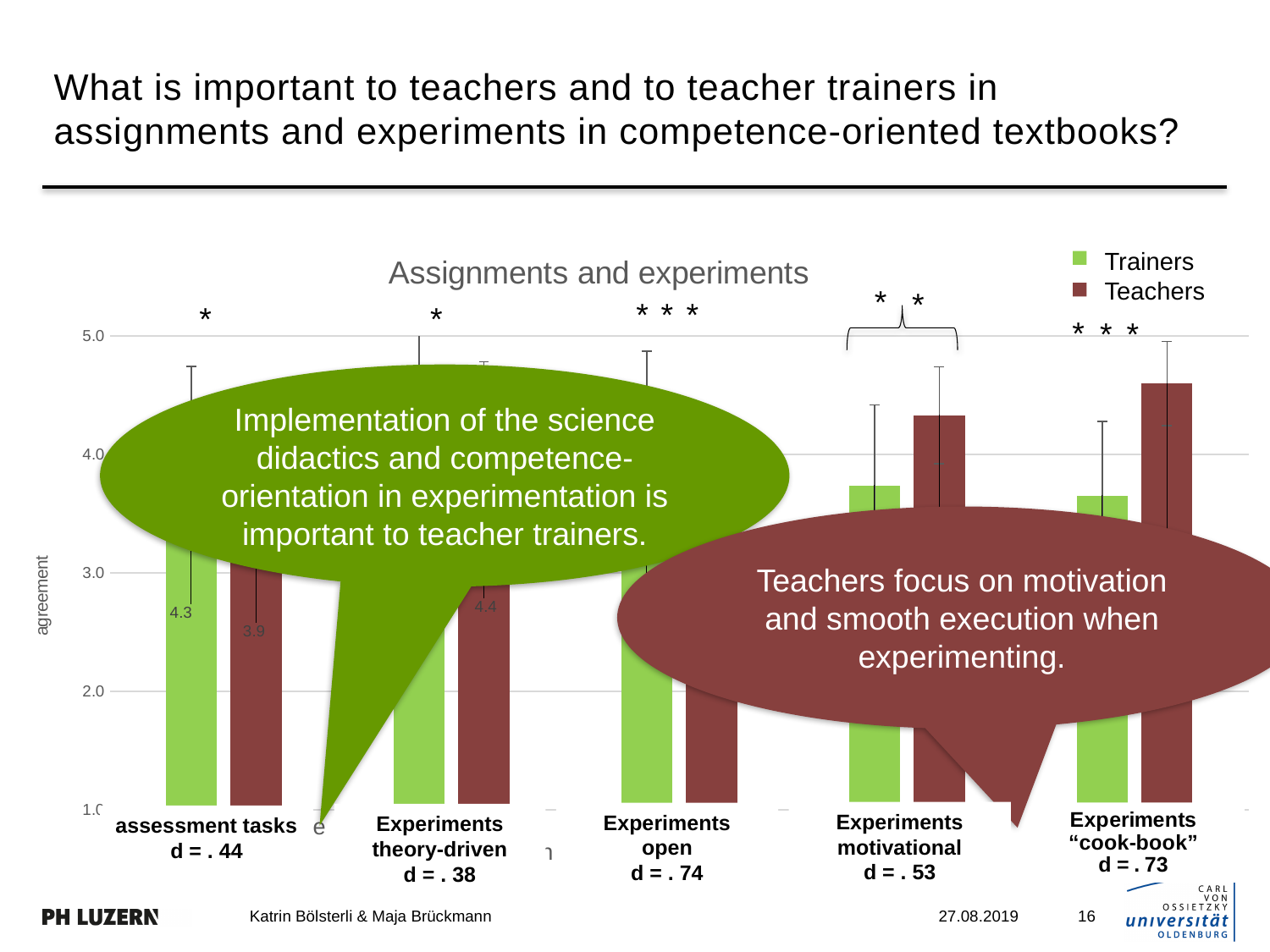
For assessment tasks, what is the difference between the Trainers value and the Teachers value? 0.4 Is the Teachers value for Experiments motivational greater or less than 4.0? greater What kind of chart is shown on the slide? bar chart For Experiments "cook-book", which series has the larger value, Trainers or Teachers? Teachers What is the Teachers value for assessment tasks? 3.9 What are the two series named in the chart legend? Trainers and Teachers Is the Trainers value for Experiments "cook-book" greater or less than 4.0? less What is the title of the chart? Assignments and experiments What is the Trainers value for assessment tasks? 4.3 How many series does the legend of the chart list? 2 For assessment tasks, which series has the larger value, Trainers or Teachers? Trainers